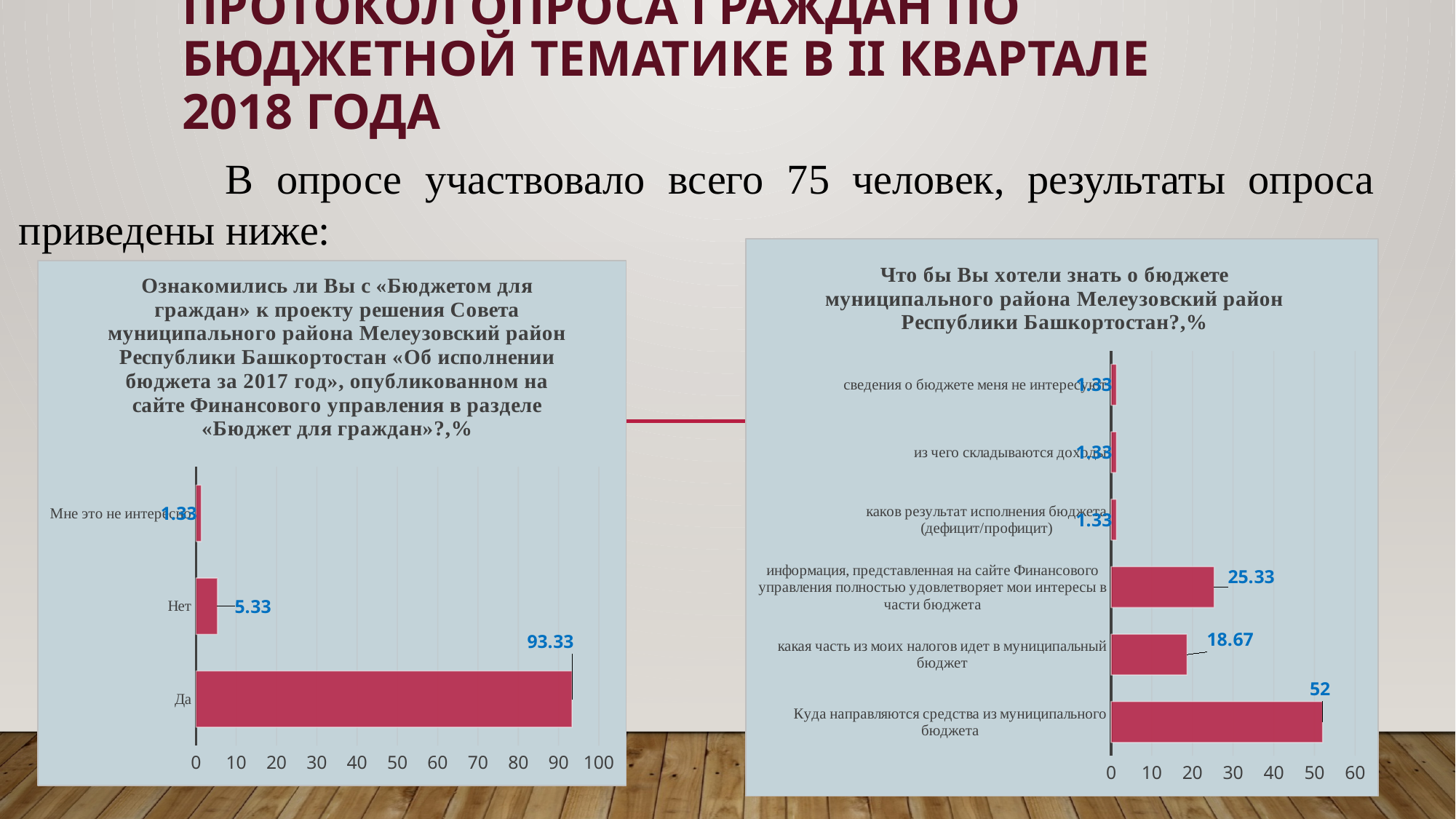
In the left chart, how many categories are shown? 3 In the right chart, what is the difference between the values for «Куда направляются средства из муниципального бюджета» and «информация, представленная на сайте Финансового управления полностью удовлетворяет мои интересы в части бюджета»? 26.67 In the left chart, what is the value for «Нет»? 5.33 In the right chart, what is the value for «какая часть из моих налогов идет в муниципальный бюджет»? 18.67 In the left chart, what is the value for «Да»? 93.33 In the right chart, which is larger: the value for «информация, представленная на сайте Финансового управления полностью удовлетворяет мои интересы в части бюджета» or for «какая часть из моих налогов идет в муниципальный бюджет»? информация, представленная на сайте Финансового управления полностью удовлетворяет мои интересы в части бюджета In the left chart, which category has the highest value? Да In the right chart, which category has the highest value? Куда направляются средства из муниципального бюджета In the right chart, how many categories are shown? 6 In the right chart, what is the value for «Куда направляются средства из муниципального бюджета»? 52 In the left chart, what is the difference between the values for «Да» and «Нет»? 88 What type of chart is the left chart? Bar chart